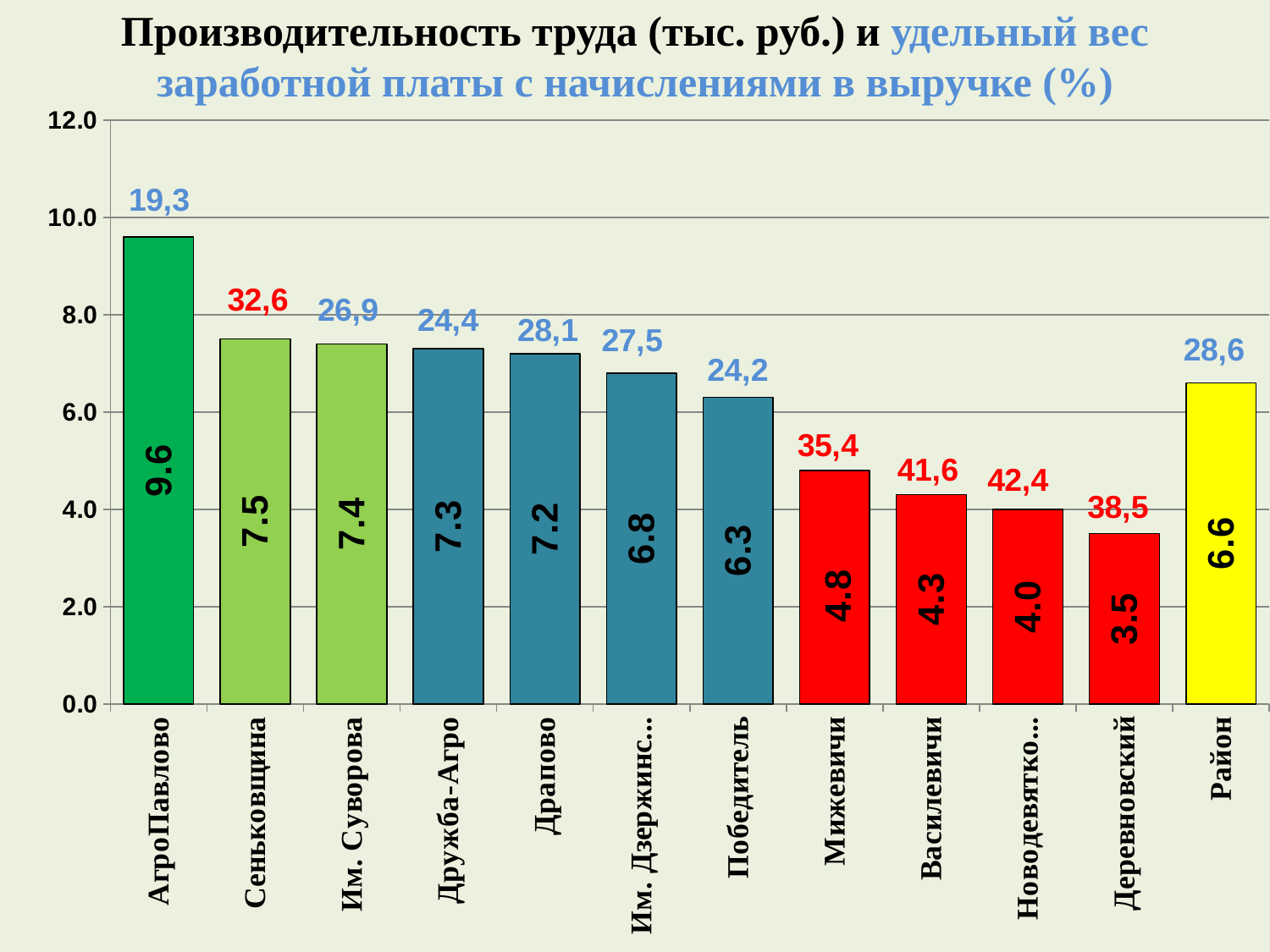
Which category has the highest labor productivity bar? АгроПавлово What is the labor productivity value shown inside the bar for Район? 6.6 What is the labor productivity value (the number inside the bar) for АгроПавлово? 9.6 What is the share of wages in revenue (the percentage label above the bar) for Василевичи? 41,6 What type of chart is shown on the slide? bar chart What is the percentage label shown above the bar for Сеньковщина? 32,6 What is the difference between the labor productivity values of АгроПавлово and Деревновский? 6.1 Which has a larger labor productivity value, Мижевичи or Победитель? Победитель Which category has the lowest labor productivity bar? Деревновский Do the labor productivity values of the farms (excluding Район) rise or fall from left to right along the x axis? fall How many bars are plotted in the chart? 12 What colour is the bar for Район? yellow